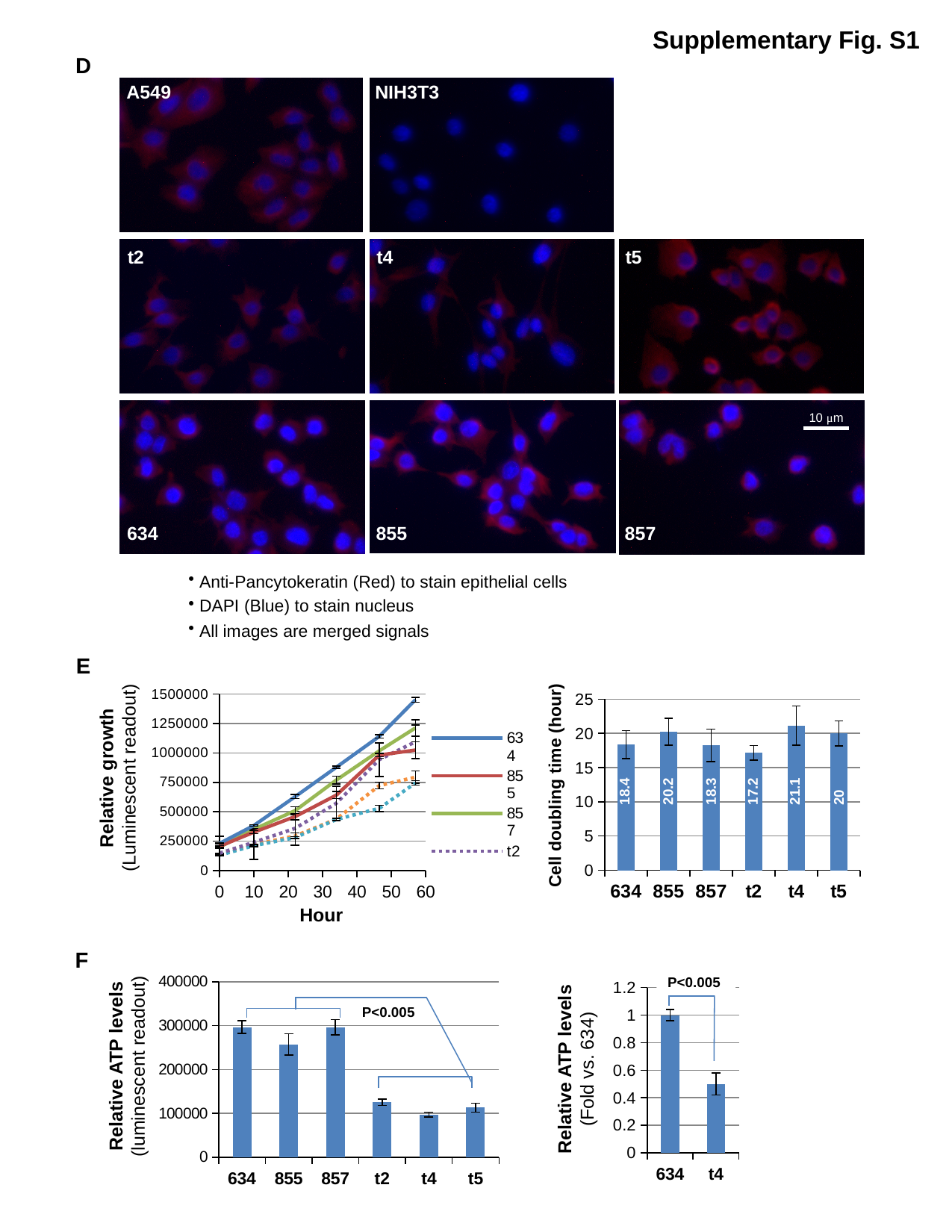
In the cell doubling time bar chart, what is the difference between the values for t4 and t2? 3.9 In the relative ATP levels (luminescent readout) bar chart in panel F, which is larger, the value for 855 or the value for t2? 855 How many categories are shown in the cell doubling time bar chart? 6 In the relative ATP levels (Fold vs. 634) bar chart in panel F, is the value for t4 greater or less than 0.6? less What kind of chart is the relative growth chart in panel E? line chart In the cell doubling time bar chart, which category has the lowest doubling time? t2 In the cell doubling time bar chart, which category has the highest doubling time? t4 In the cell doubling time bar chart, what is the value for 855? 20.2 In the relative ATP levels (luminescent readout) bar chart in panel F, which category has the lowest value? t4 In the relative ATP levels (luminescent readout) bar chart in panel F, is the value for 634 greater or less than 200000? greater In the relative growth line chart in panel E, do the values rise or fall as the hours increase? rise In the cell doubling time bar chart, what is the value for t4? 21.1